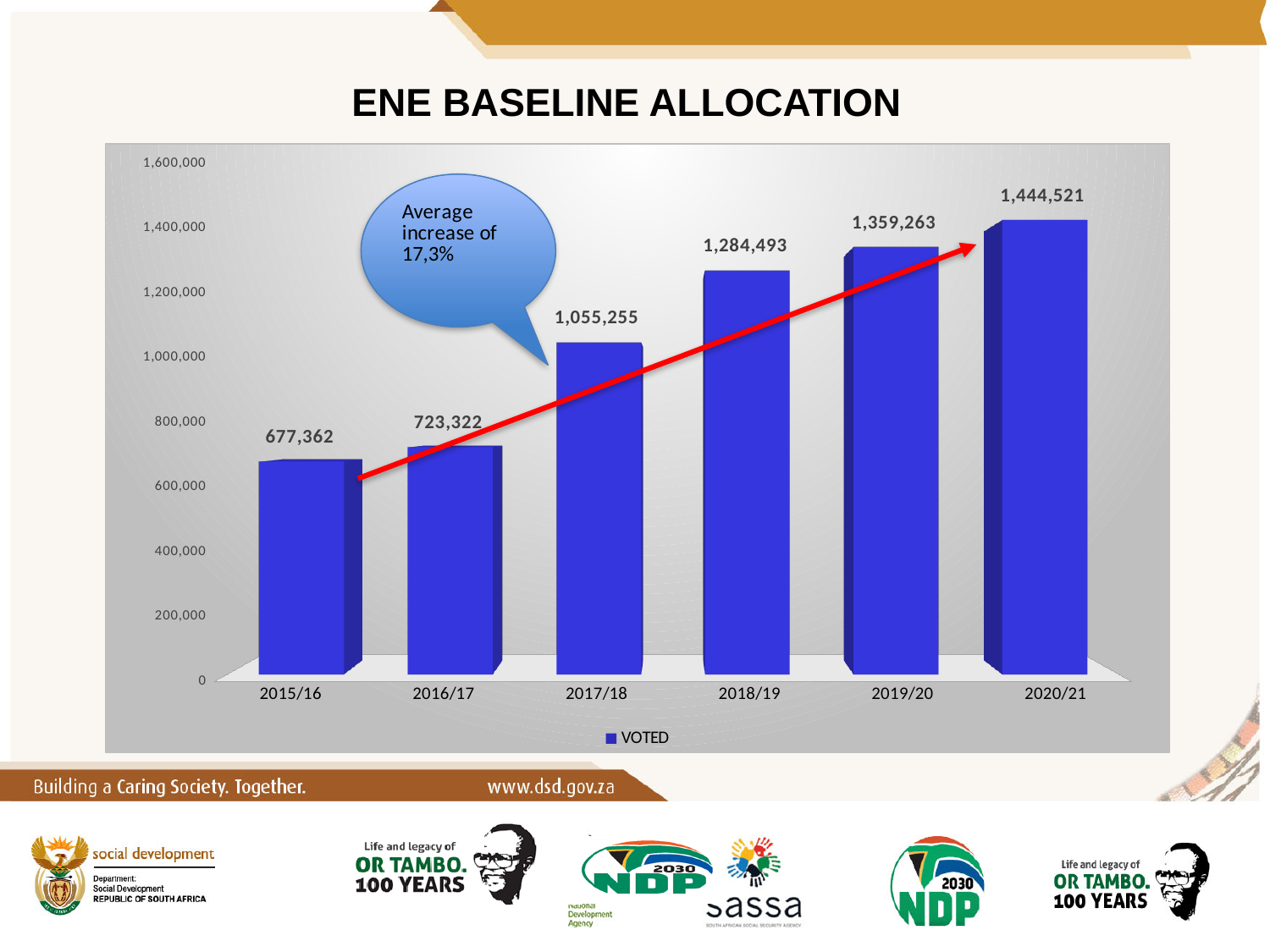
Which year has the lowest VOTED allocation? 2015/16 What kind of chart is shown on the slide? bar chart Do the VOTED values rise or fall from 2015/16 to 2020/21? rise Is the VOTED value for 2019/20 greater or less than 1,200,000? greater How many years are shown on the x axis? 6 Which year has the highest VOTED allocation? 2020/21 What is the difference between the VOTED values for 2020/21 and 2019/20? 85,258 Which is larger, the VOTED value for 2016/17 or for 2017/18? 2017/18 What is the VOTED value for 2020/21? 1,444,521 What is the difference between the VOTED values for 2017/18 and 2016/17? 331,933 What is the VOTED value for 2015/16? 677,362 What is the VOTED value for 2018/19? 1,284,493